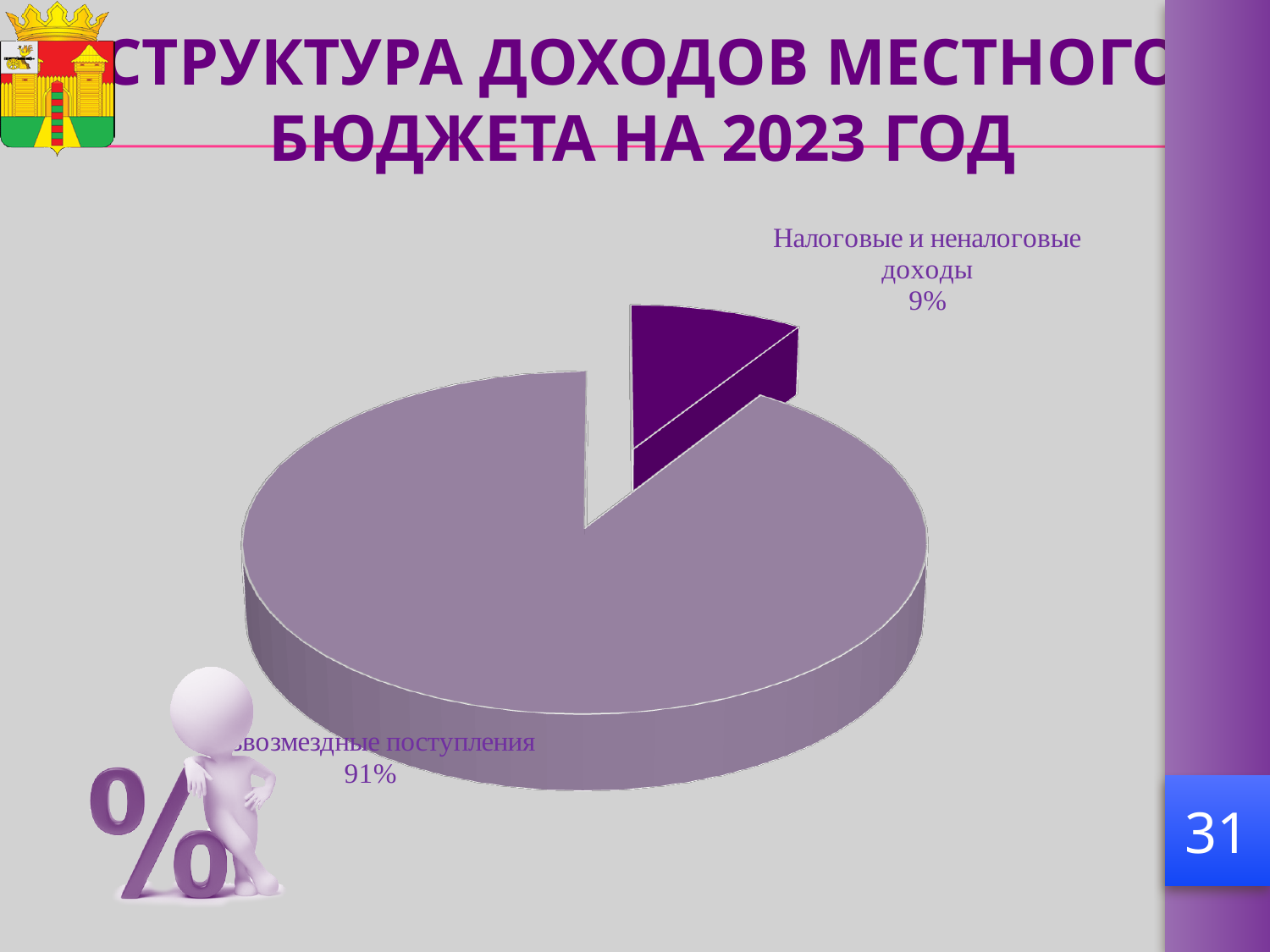
How many slices does the pie chart have? 2 What is the total of the two percentages shown on the pie chart? 100% What share of the pie does "Налоговые и неналоговые доходы" represent? 9% What is the difference in percentage points between "Безвозмездные поступления" and "Налоговые и неналоговые доходы"? 82 What share of the pie does "Безвозмездные поступления" represent? 91% What is the title of the slide containing the pie chart? СТРУКТУРА ДОХОДОВ МЕСТНОГО БЮДЖЕТА НА 2023 ГОД What kind of chart is shown on the slide? Pie chart Which category has the smallest share of the pie? Налоговые и неналоговые доходы Which category has the largest share of the pie? Безвозмездные поступления Which is larger: the share for "Налоговые и неналоговые доходы" or the share for "Безвозмездные поступления"? Безвозмездные поступления Which slice of the pie is shown in dark purple and pulled out from the rest? Налоговые и неналоговые доходы